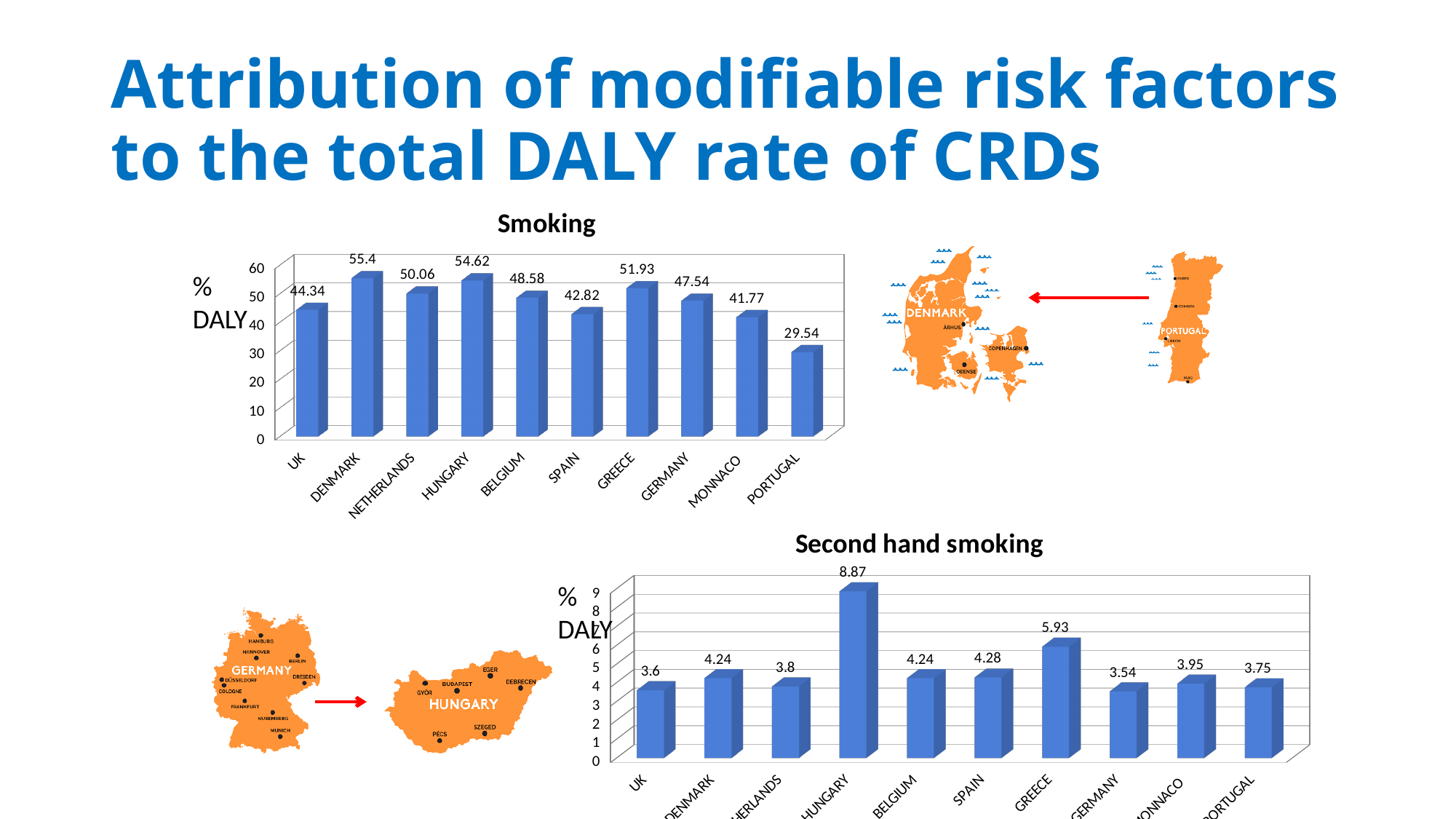
In the Second hand smoking chart, which is larger, the value for Spain or the value for Portugal? Spain In the Second hand smoking chart, which country has the highest value? Hungary In the Second hand smoking chart, what is the % DALY value for Hungary? 8.87 In the Second hand smoking chart, what is the value for Monnaco? 3.95 In the Smoking chart, which is larger, the value for Belgium or the value for Germany? Belgium In the Smoking chart, which country has the lowest value? Portugal In the Smoking chart, what is the difference between the values for Denmark and Portugal? 25.86 In the Second hand smoking chart, what is the difference between the values for Hungary and Greece? 2.94 In the Smoking chart, how many countries are shown? 10 In the Smoking chart, which country has the highest value? Denmark In the Smoking chart, what is the % DALY value for Greece? 51.93 What kind of chart is the Second hand smoking chart? Bar chart